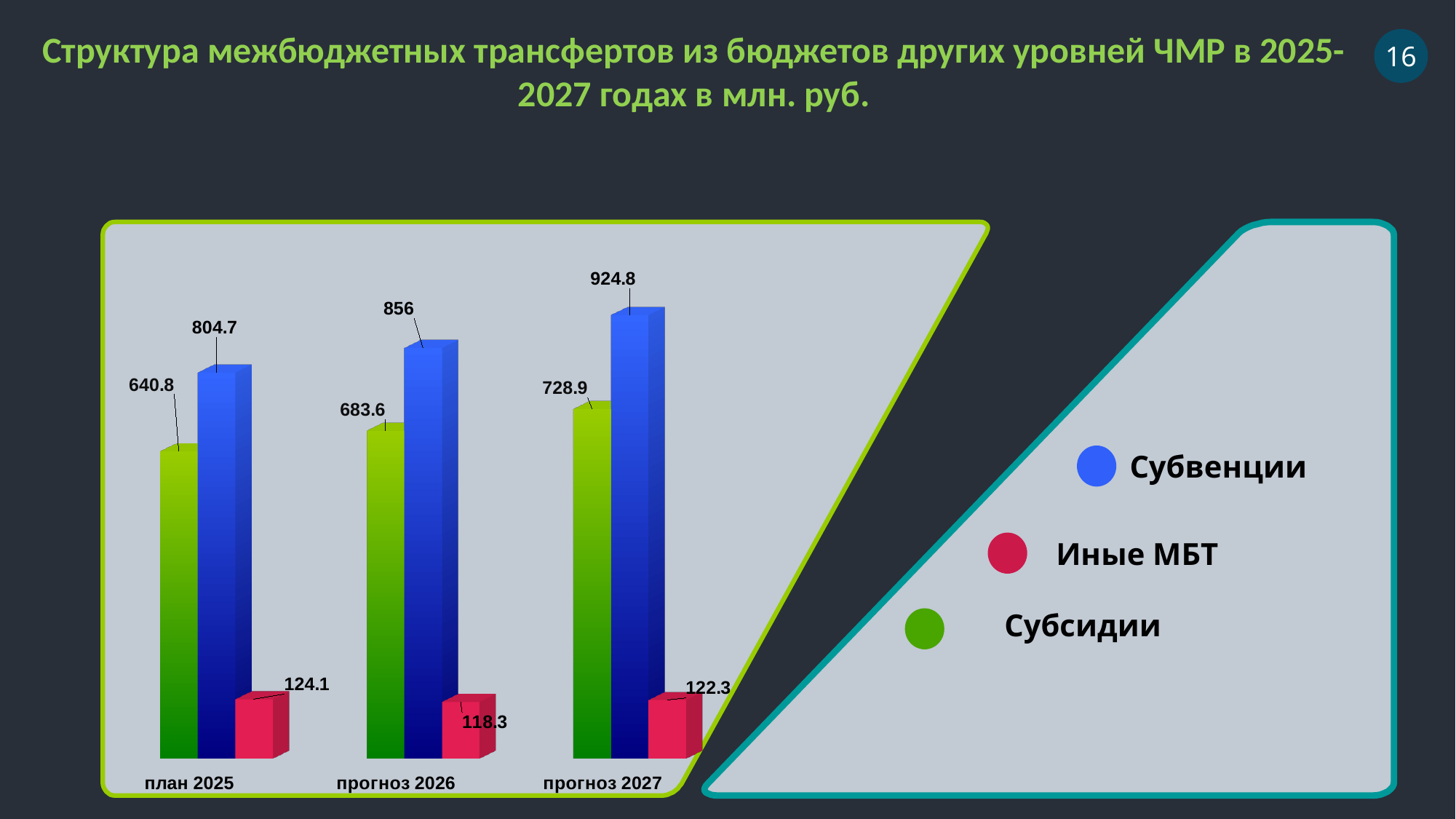
In which category is the value of Субвенции the highest? прогноз 2027 In which category is the value of Иные МБТ the lowest? прогноз 2026 What is the value of Иные МБТ for прогноз 2026? 118.3 Do the values of Субсидии rise or fall from план 2025 to прогноз 2027? rise What is the value of Субвенции for прогноз 2026? 856 What is the difference between Субвенции and Субсидии for план 2025? 163.9 How many categories are shown on the x axis? 3 Which is larger for прогноз 2027: Субсидии or Иные МБТ? Субсидии What kind of chart is shown on the slide? bar chart How many series does the legend list? 3 What is the value of Субвенции for прогноз 2027? 924.8 What is the value of Субсидии for план 2025? 640.8